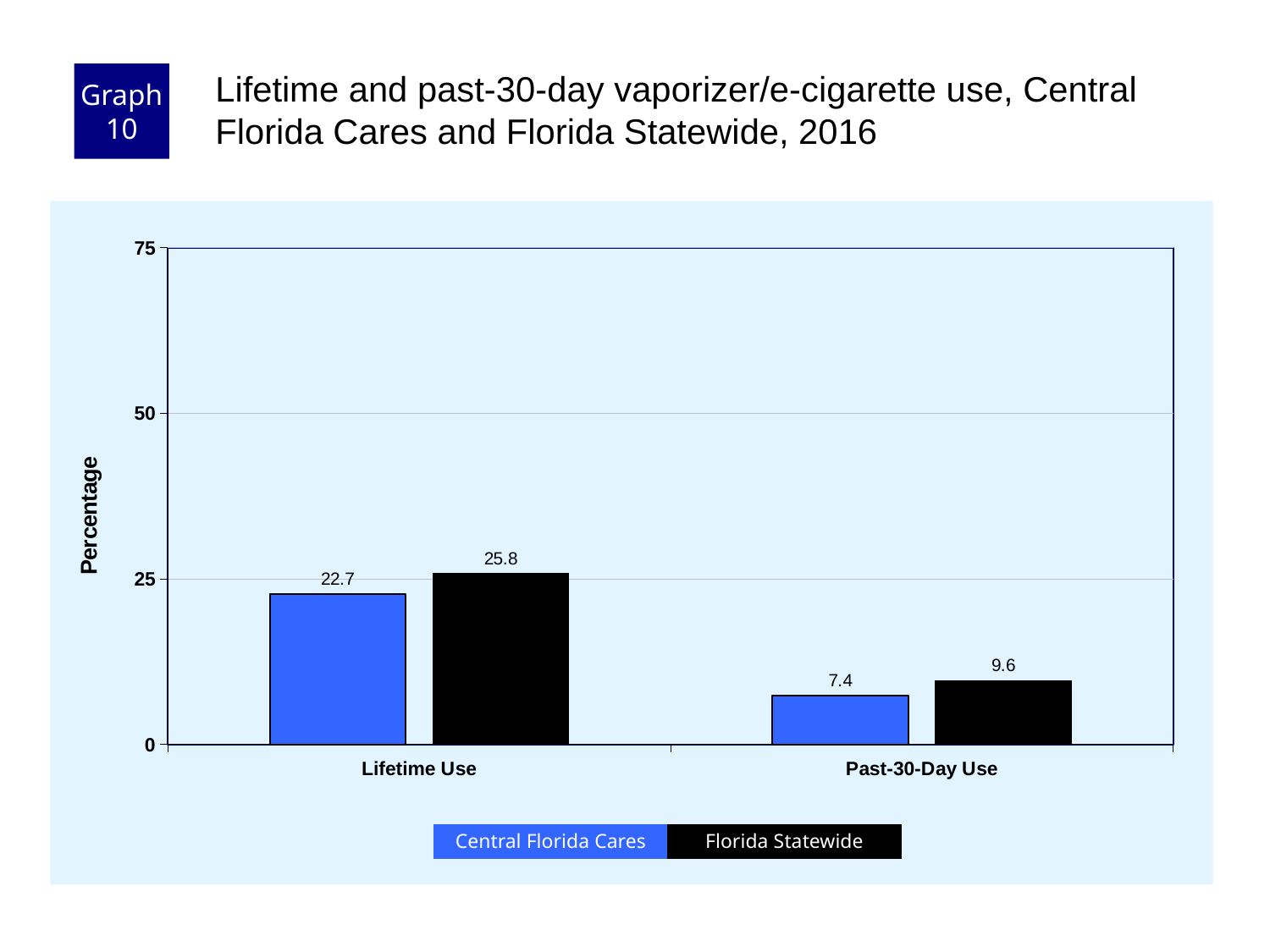
What is the Past-30-Day Use value for Central Florida Cares? 7.4 What is the label on the vertical axis? Percentage How many series does the legend list? 2 What is the difference between Florida Statewide and Central Florida Cares for Past-30-Day Use? 2.2 What is the difference between Florida Statewide and Central Florida Cares for Lifetime Use? 3.1 What is the Lifetime Use value for Florida Statewide? 25.8 Which bar has the lowest value on the chart? Central Florida Cares, Past-30-Day Use For Past-30-Day Use, which is larger: Central Florida Cares or Florida Statewide? Florida Statewide What is the Lifetime Use value for Central Florida Cares? 22.7 What kind of chart is shown on the slide? Bar chart Which bar has the highest value on the chart? Florida Statewide, Lifetime Use What is the Past-30-Day Use value for Florida Statewide? 9.6